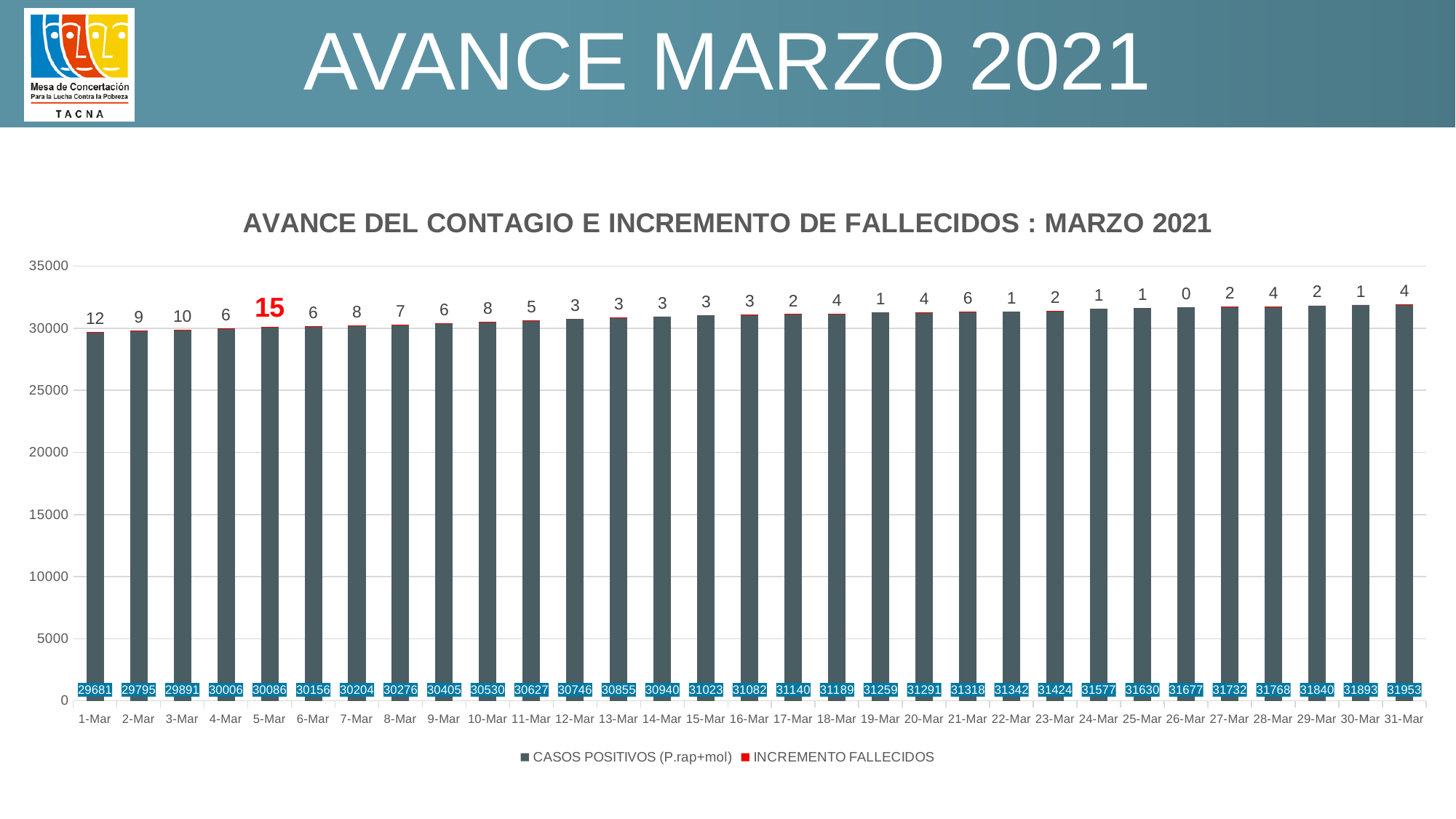
What is the value of CASOS POSITIVOS (P.rap+mol) on 1-Mar? 29681 How many series does the legend list? 2 On which date is INCREMENTO FALLECIDOS lowest? 26-Mar Is the value of CASOS POSITIVOS (P.rap+mol) on 15-Mar greater or less than 30000? greater On which date is INCREMENTO FALLECIDOS highest? 5-Mar By how much did CASOS POSITIVOS (P.rap+mol) increase from 1-Mar to 31-Mar? 2272 What kind of chart is shown? bar chart What is the value of CASOS POSITIVOS (P.rap+mol) on 31-Mar? 31953 Which date has a larger INCREMENTO FALLECIDOS value, 1-Mar or 2-Mar? 1-Mar What is the value of INCREMENTO FALLECIDOS on 5-Mar? 15 How many dates are shown on the x axis? 31 Do the CASOS POSITIVOS (P.rap+mol) values rise or fall from 1-Mar to 31-Mar? rise